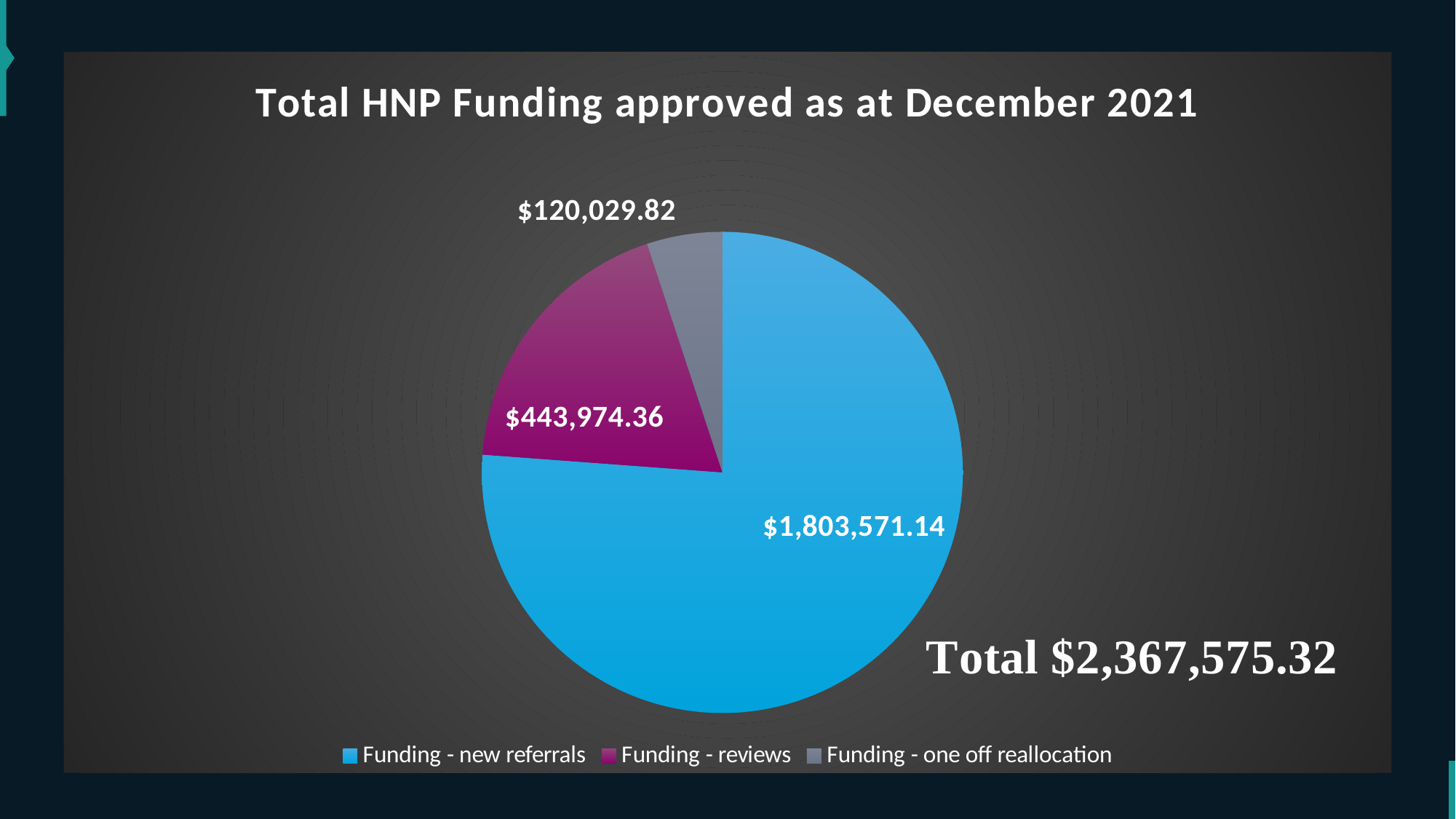
What is the difference between Funding - reviews and Funding - one off reallocation? $323,944.54 How many slices does the pie chart have? 3 Which category has the largest slice of the pie? Funding - new referrals What is the value for Funding - new referrals? $1,803,571.14 Which is larger, Funding - reviews or Funding - one off reallocation? Funding - reviews What is the value for Funding - one off reallocation? $120,029.82 What total funding amount is shown on the slide? $2,367,575.32 What is the value for Funding - reviews? $443,974.36 What is the difference between Funding - new referrals and Funding - reviews? $1,359,596.78 Which category has the smallest slice of the pie? Funding - one off reallocation What is the title of the chart? Total HNP Funding approved as at December 2021 What kind of chart is shown on the slide? Pie chart